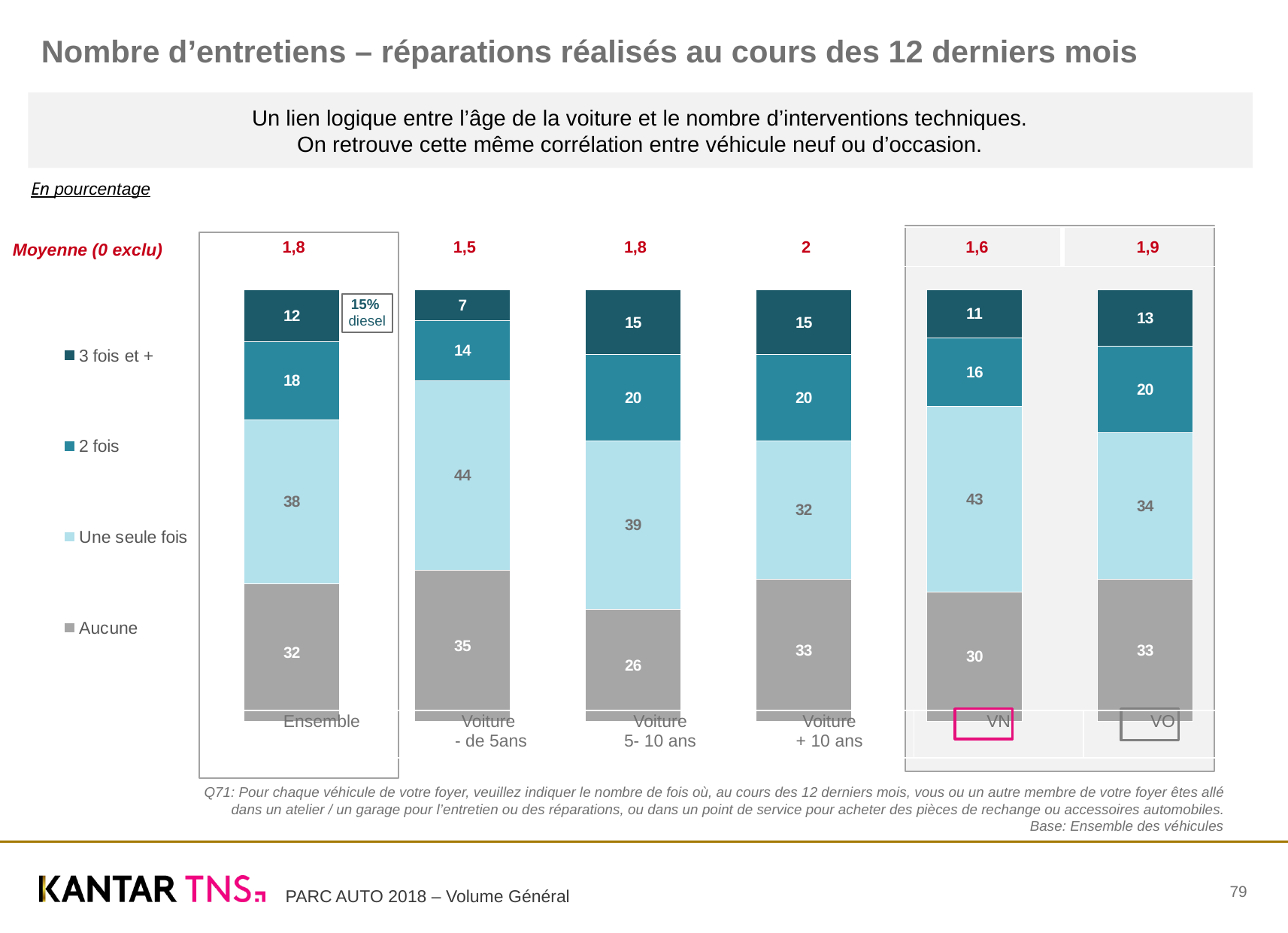
What is the value of 'Aucune' for 'Voiture 5- 10 ans'? 26 Which category has the lowest value for 'Aucune'? Voiture 5- 10 ans What is the 'Moyenne (0 exclu)' shown for 'Voiture + 10 ans'? 2 What is the total of the stacked bar for 'VN'? 100 Which is larger: the '2 fois' value for 'Ensemble' or for 'Voiture - de 5ans'? Ensemble How many categories (bars) are plotted in the chart? 6 What is the 'Moyenne (0 exclu)' shown for 'VO'? 1,9 How many series does the legend list? 4 What is the difference between the 'Une seule fois' values for VN and VO? 9 Which category has the highest value for '3 fois et +'? Voiture 5- 10 ans and Voiture + 10 ans (15) What is the value of 'Une seule fois' for 'Voiture - de 5ans'? 44 What type of chart is shown on the slide? stacked bar chart